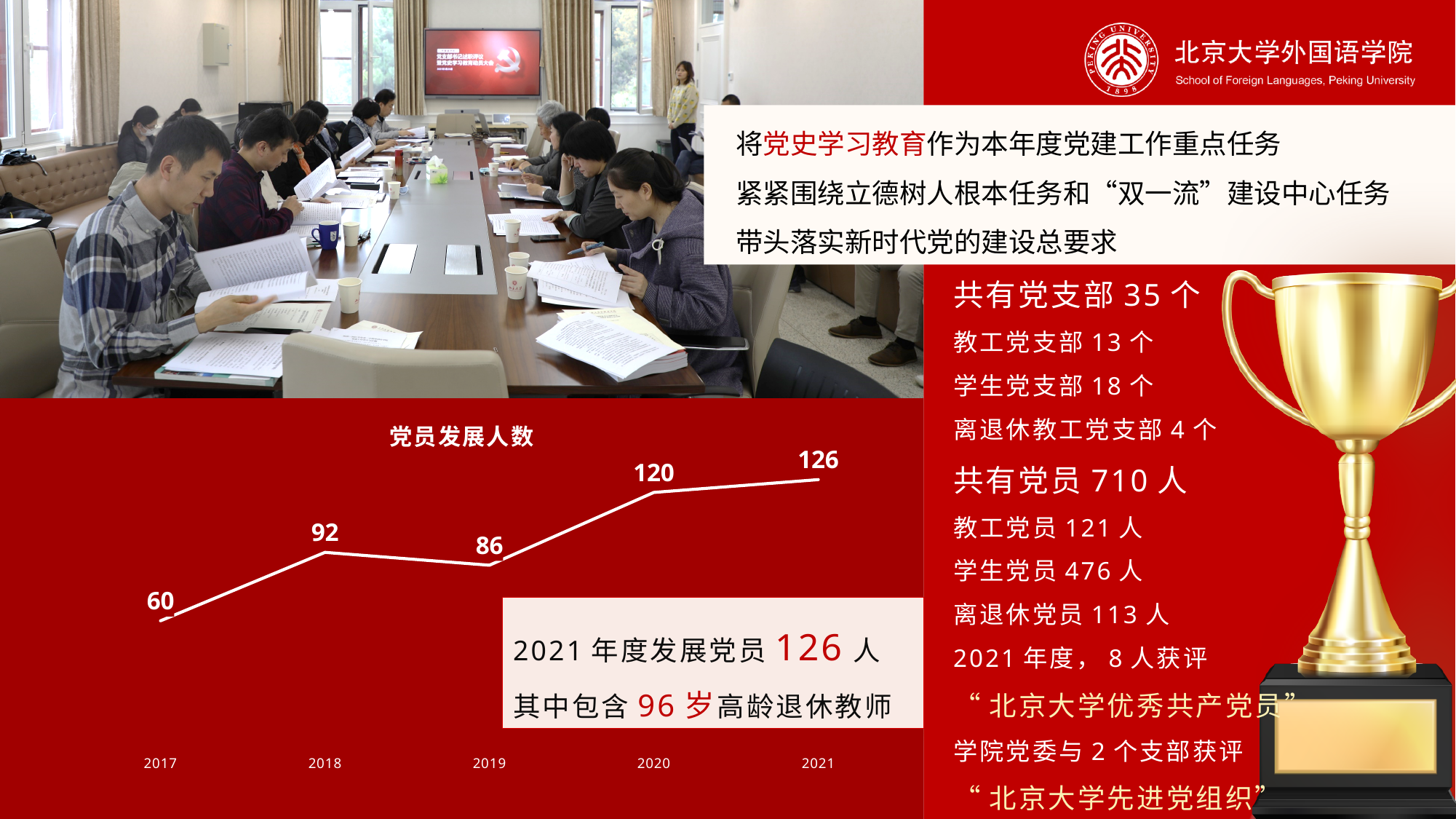
Does the value in the 党员发展人数 chart rise or fall from 2019 to 2020? rise What is the value for 2021 in the 党员发展人数 chart? 126 What kind of chart is the 党员发展人数 chart? line chart What is the value for 2017 in the 党员发展人数 chart? 60 What is the title of the chart on the slide? 党员发展人数 Which year has the highest value in the 党员发展人数 chart? 2021 What is the difference between the 2021 and 2017 values in the 党员发展人数 chart? 66 Which year has the lowest value in the 党员发展人数 chart? 2017 Which is larger in the 党员发展人数 chart, the value for 2018 or the value for 2019? 2018 What is the difference between the 2018 and 2019 values in the 党员发展人数 chart? 6 What is the value for 2019 in the 党员发展人数 chart? 86 How many years are plotted in the 党员发展人数 chart? 5